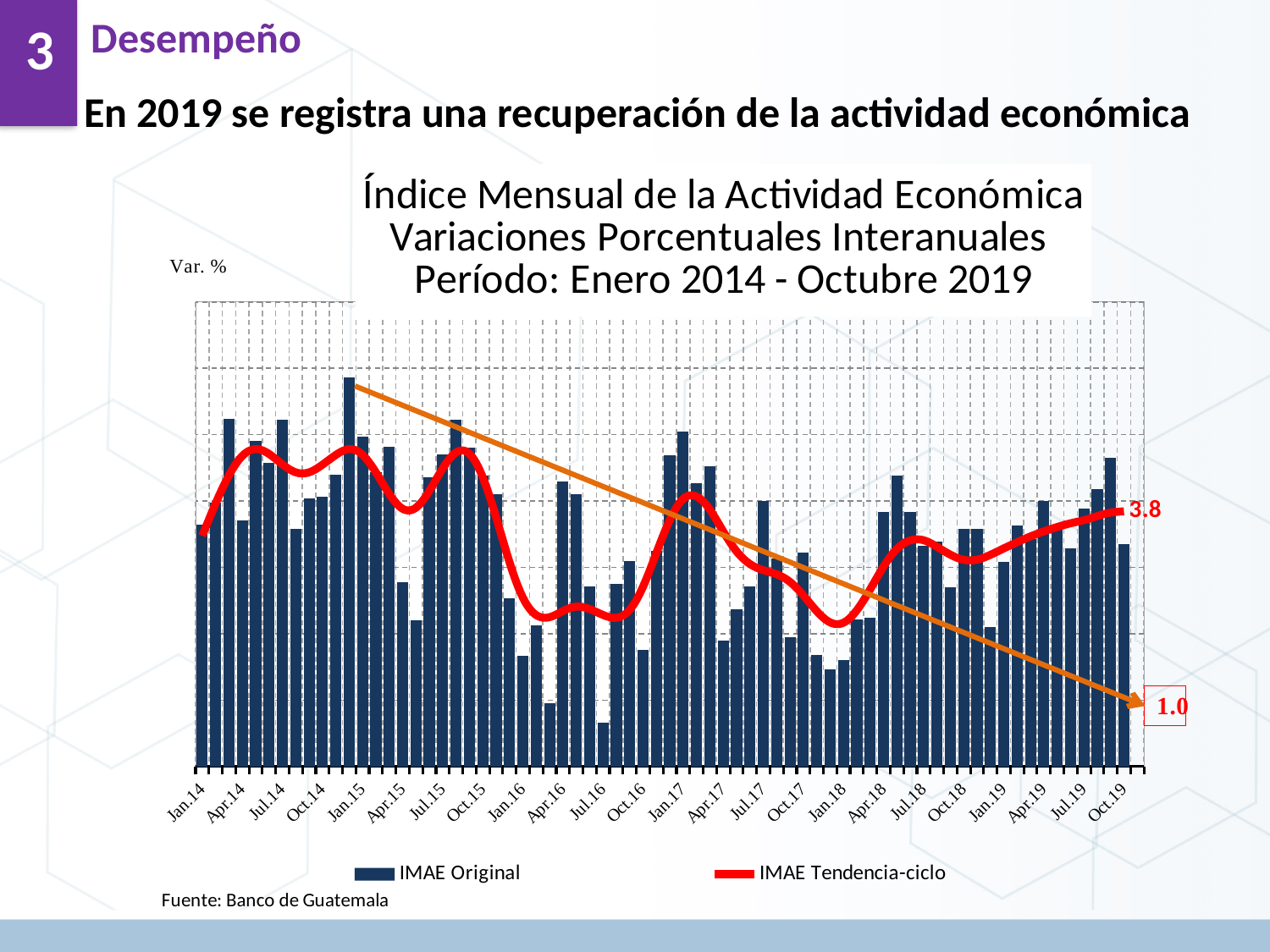
According to the orange arrow, does the overall level of the series rise or fall from Jan.14 to Oct.19? Fall What is the source cited below the chart? Banco de Guatemala Which is larger, the IMAE Original bar for Jan.15 or for Jan.18? Jan.15 Which is larger, the IMAE Original bar for Oct.15 or for Oct.17? Oct.15 What are the two series named in the legend? IMAE Original and IMAE Tendencia-ciclo What period does the chart title say the data covers? Enero 2014 - Octubre 2019 Which month has the shortest IMAE Original bar? Jul.16 How many series does the legend list? 2 What value is labelled at the tip of the orange arrow on the right of the chart? 1.0 Which month has the tallest IMAE Original bar? Dec.14 What value is labelled at the end of the red IMAE Tendencia-ciclo line in Oct.19? 3.8 What kind of chart is used to show the IMAE Original series? Bar chart